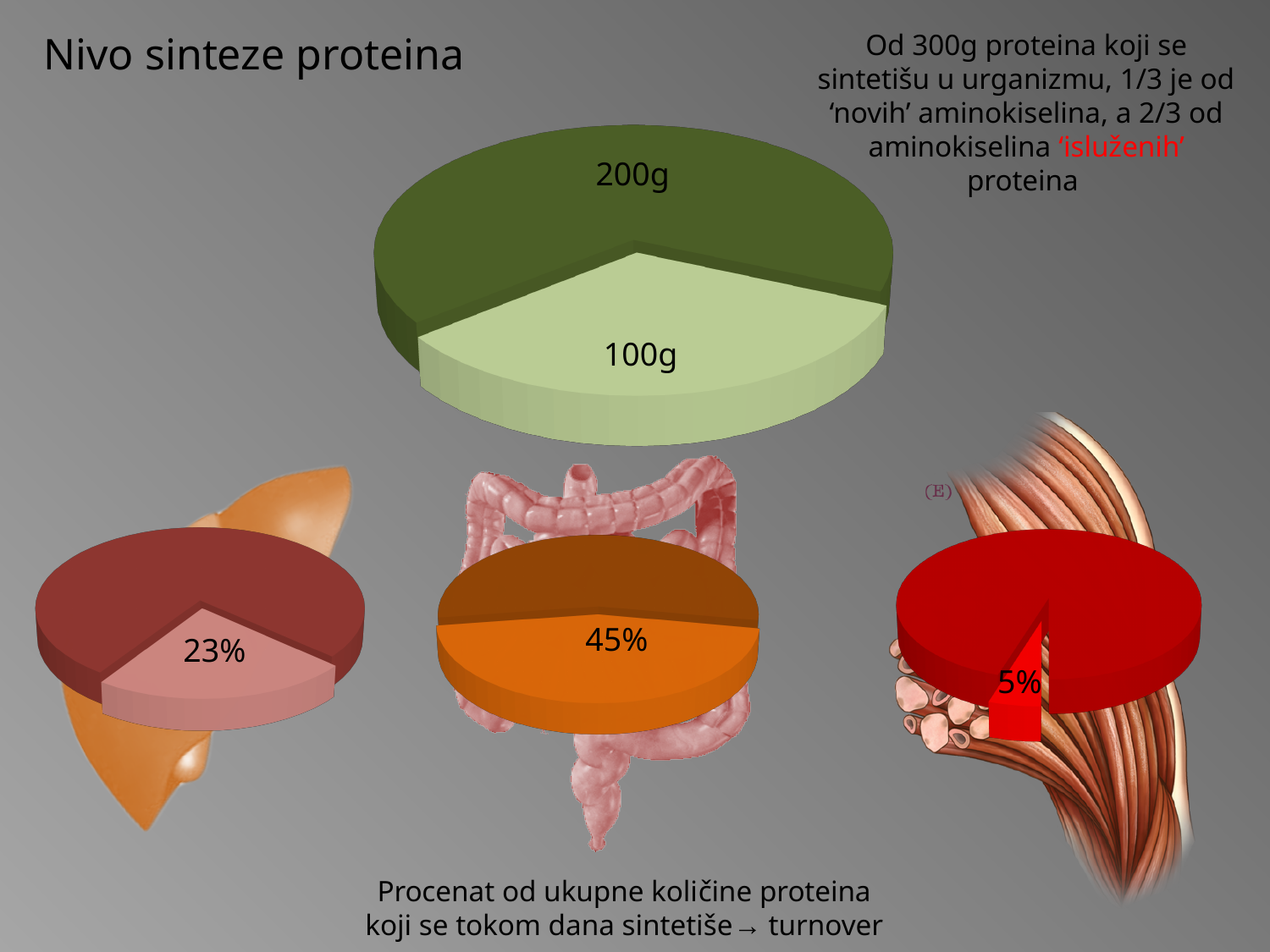
In the top pie chart, what share of the whole does the 100g slice represent? 1/3 In the top pie chart, what is the value of the smaller (light green) slice? 100g Among the three bottom pie charts, which one shows the smallest labelled percentage? the bottom-right pie chart (5%) In the bottom-left pie chart (over the liver image), what percentage is shown on the pulled-out slice? 23% How many slices does the top pie chart have? 2 What kind of chart is shown at the top of the slide? pie chart In the top pie chart, what is the total of the two slices? 300g In the top pie chart, what is the value of the larger (dark green) slice? 200g In the bottom-right pie chart (over the muscle image), what percentage is shown on the pulled-out slice? 5% In the top pie chart, what is the difference between the two slices? 100g In the bottom-middle pie chart (over the intestine image), what percentage is shown? 45% In the top pie chart, which slice is larger, the one labelled 200g or the one labelled 100g? 200g